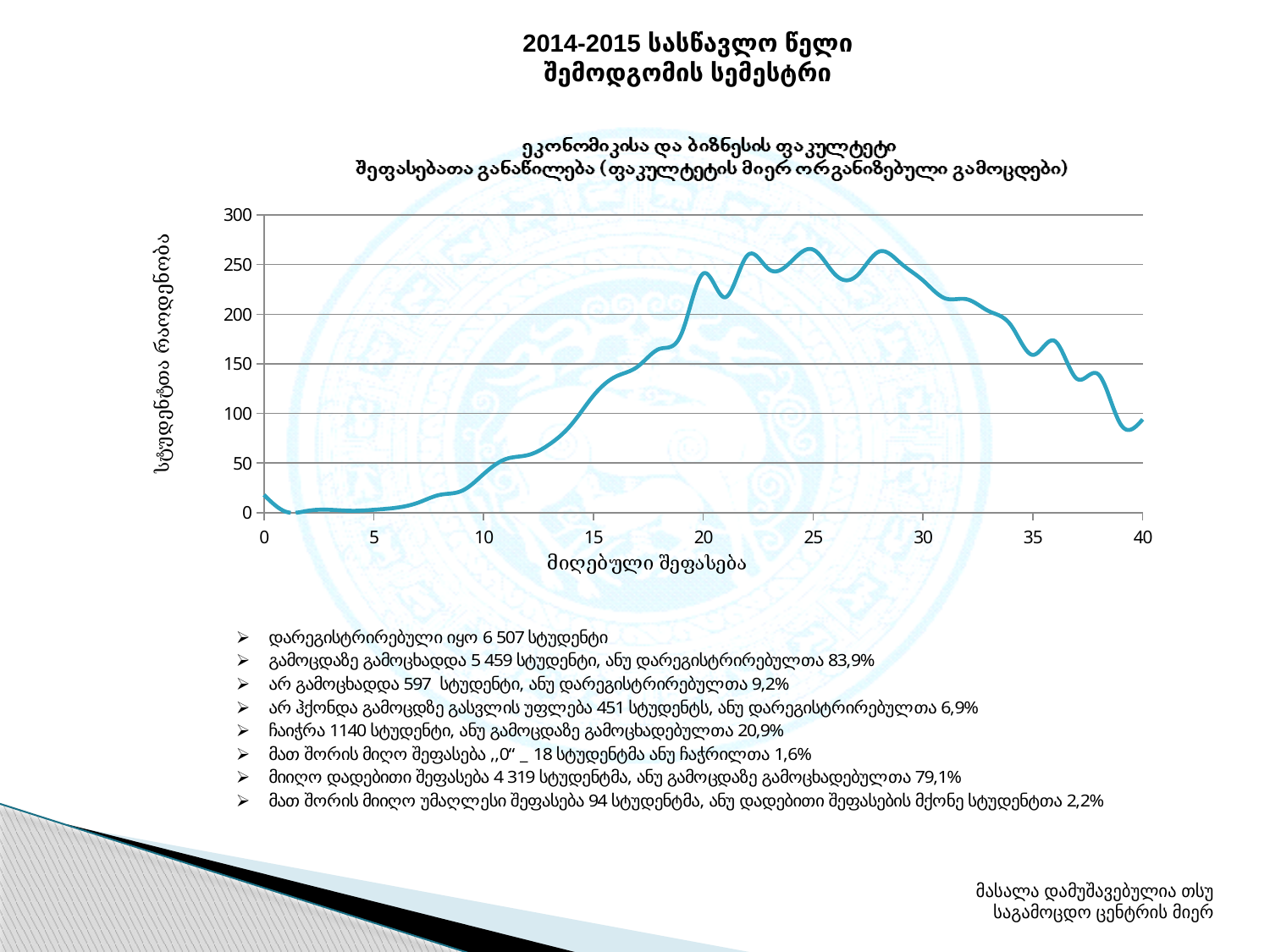
Is the value for score 40 greater or less than 50? greater Is the value for score 20 greater or less than 200? greater What kind of chart is shown on the slide? line chart Does the line generally rise or fall between scores 10 and 20? rise Is the value for score 5 greater or less than 50? less What is the label of the x axis? მიღებული შეფასება What is the maximum value shown on the y axis? 300 Does the line generally rise or fall between scores 30 and 40? fall How many lines (data series) are plotted on the chart? 1